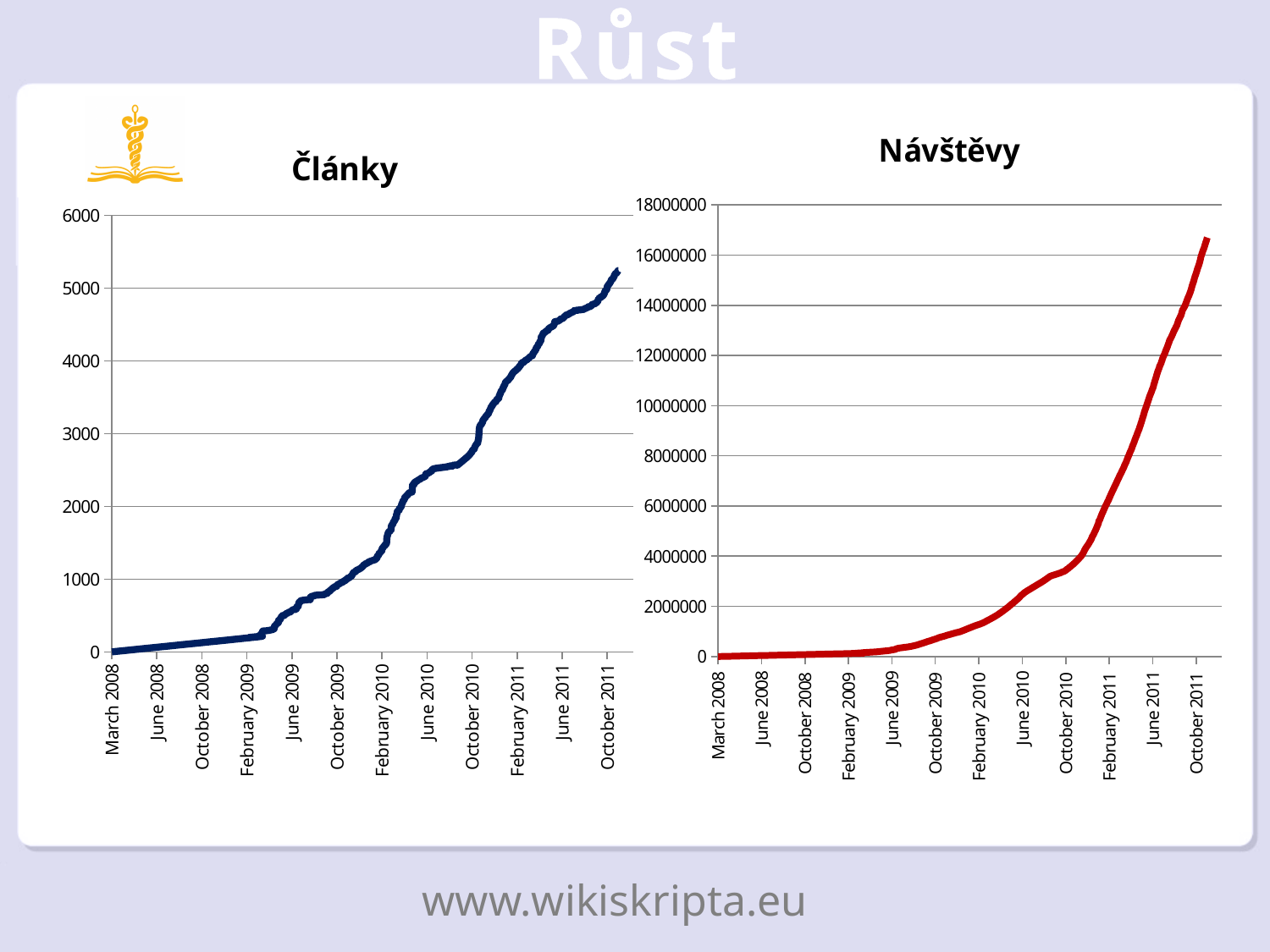
In the "Články" chart, is the value at June 2010 greater or less than 2000? greater In the "Návštěvy" chart, is the value at October 2011 greater or less than 14000000? greater In the "Články" chart, is the value at February 2009 greater or less than 1000? less In the "Články" chart, do the values rise or fall from March 2008 to October 2011? rise What colour is the line in the "Návštěvy" chart? red What kind of chart is the "Články" chart? line chart What kind of chart is the "Návštěvy" chart? line chart In the "Návštěvy" chart, do the values rise or fall along the x axis? rise In the "Články" chart, at which x-axis label is the value lowest? March 2008